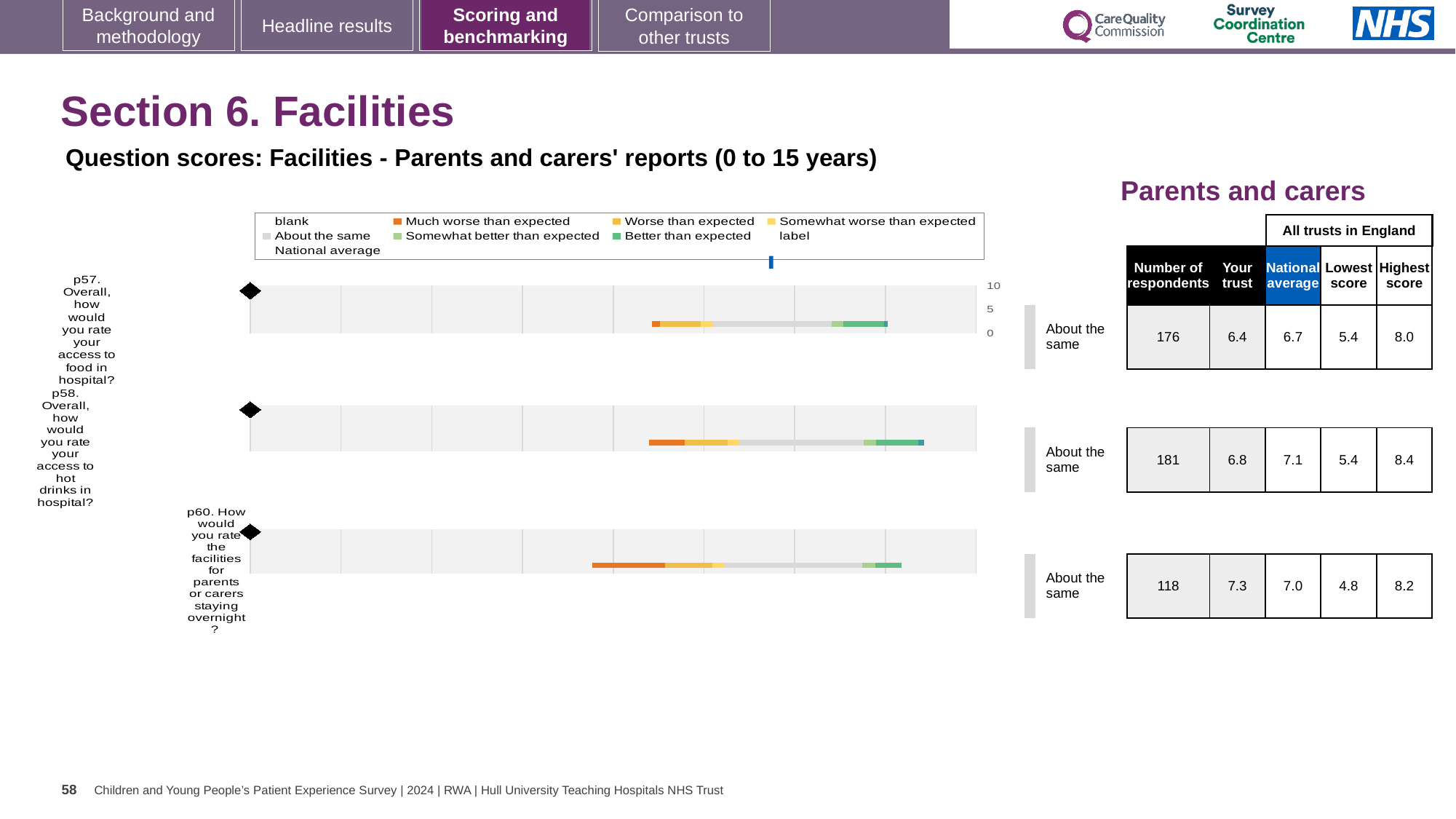
What kind of chart is used to show the question scores for p57, p58 and p60? Bar chart For p57, which is larger: the 'Your trust' score or the national average? National average What is the 'Your trust' score for p57 (access to food in hospital)? 6.4 What is the national average score for p58 (access to hot drinks in hospital)? 7.1 What is the subtitle above the charts? Question scores: Facilities - Parents and carers' reports (0 to 15 years) How many questions (chart rows) are shown on the slide? 3 For p58, what is the difference between the highest score and the lowest score among all trusts in England? 3.0 What benchmark category is shown for p57, p58 and p60? About the same Which question has the lowest 'Lowest score' among all trusts in England? p60. How would you rate the facilities for parents or carers staying overnight? How many respondents answered p60 (facilities for parents or carers staying overnight)? 118 Which question has the highest 'Your trust' score? p60. How would you rate the facilities for parents or carers staying overnight? For p60, how much higher is the 'Your trust' score than the national average? 0.3